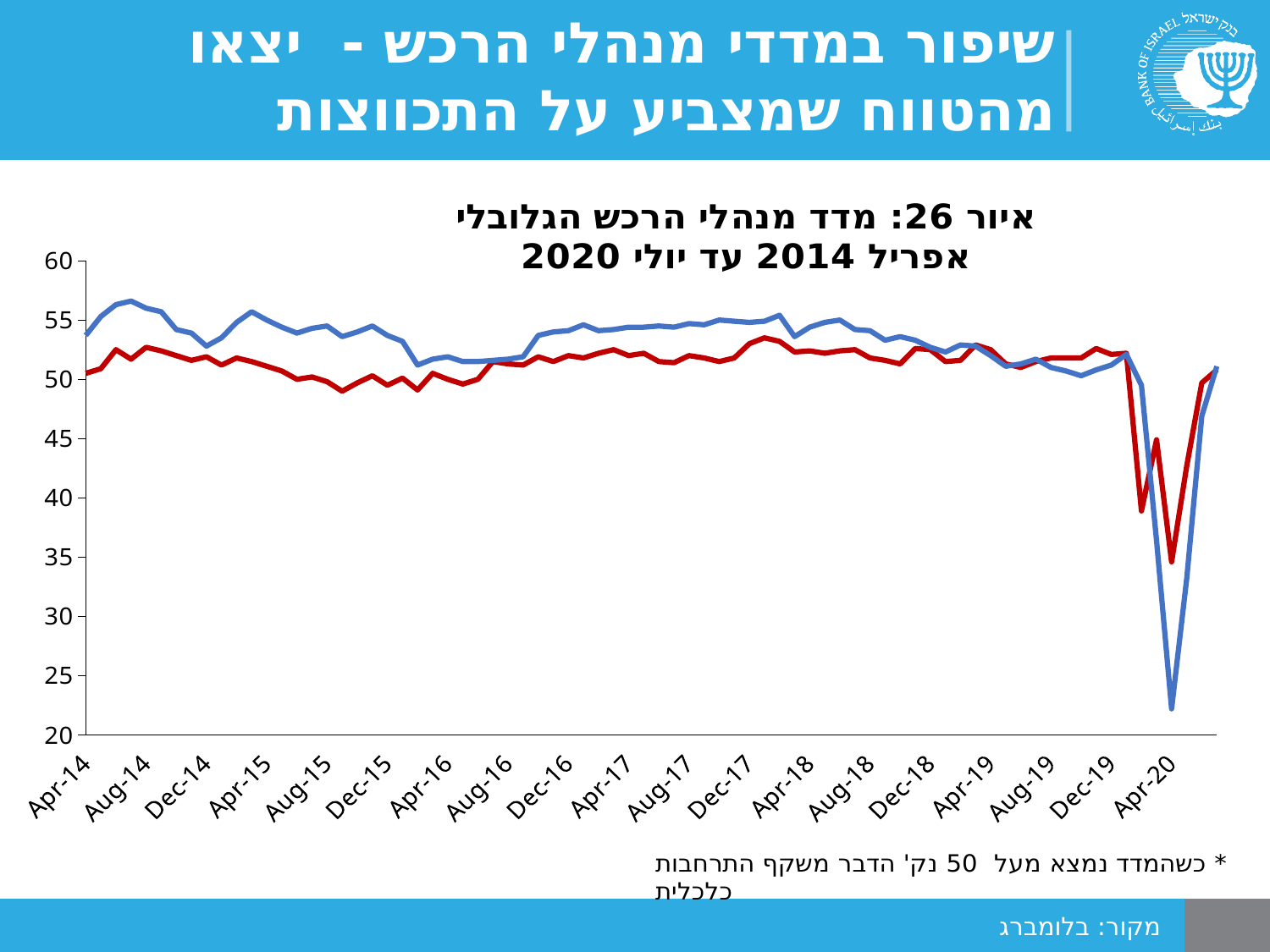
Is the value of the blue line at Aug-14 greater or less than 55? greater Is the value of the red line at Apr-20 greater or less than 40? less What kind of chart is shown on the slide? line chart Which line reaches the lowest value on the chart, the blue line or the red line? the blue line How many lines are plotted on the chart? 2 Do the values of both lines rise or fall between Dec-19 and Apr-20? fall Is the value of the blue line at Apr-14 greater or less than 50? greater What is the source given at the bottom of the slide? בלומברג What is the title of the chart? איור 26: מדד מנהלי הרכש הגלובלי אפריל 2014 עד יולי 2020 At Apr-20, which line has the larger value, the blue line or the red line? the red line At which x-axis label does the blue line reach its lowest point? Apr-20